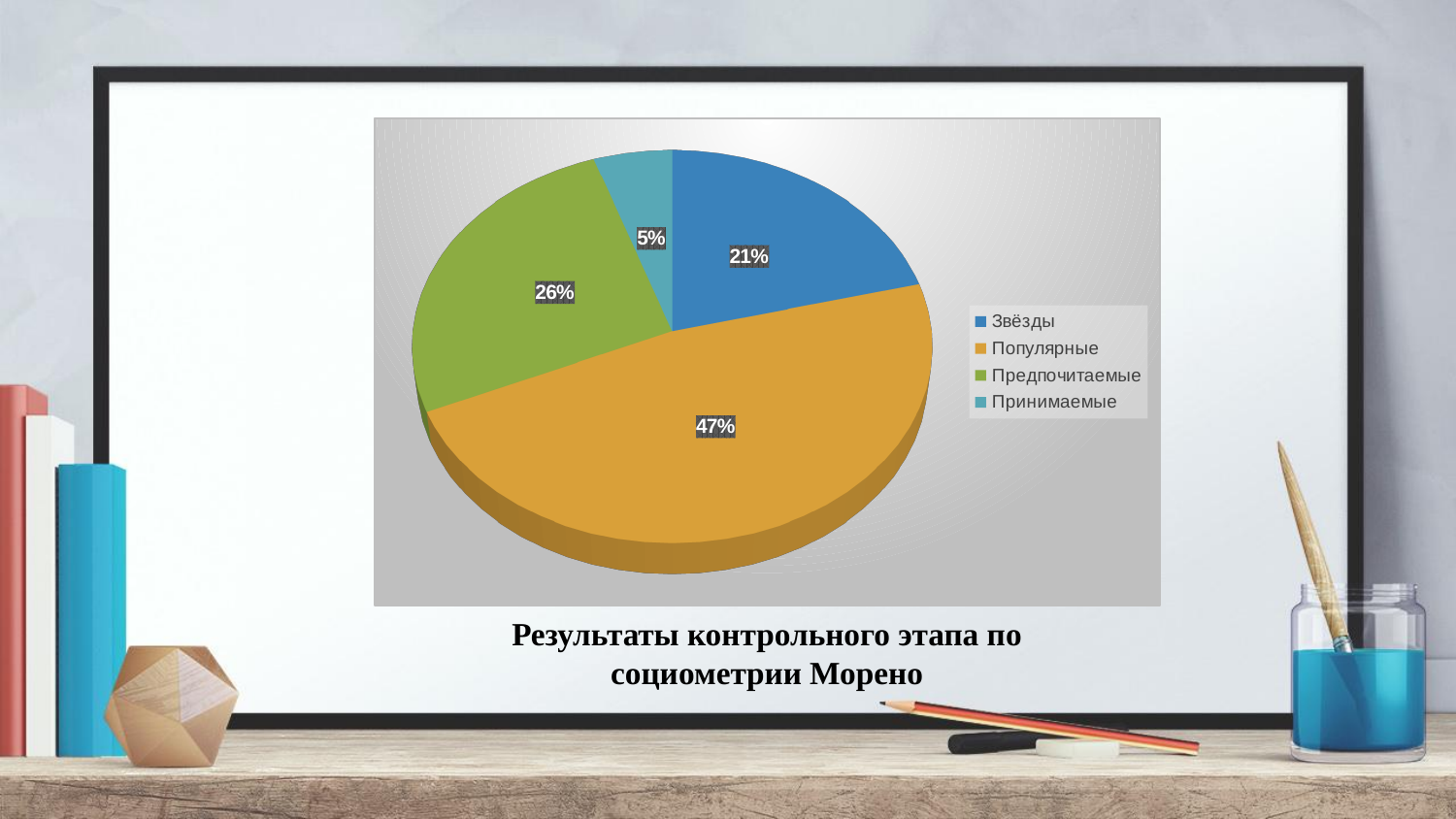
Which category has the smallest slice of the pie? Принимаемые What share of the pie does the Популярные slice take? 47% Which category has the largest slice of the pie? Популярные Which is larger, the Звёзды slice or the Предпочитаемые slice? Предпочитаемые What is the difference between the Популярные and Предпочитаемые shares? 21% What is the value shown for Предпочитаемые? 26% What colour is the Популярные slice in the pie chart? Orange What is the difference between the Звёзды and Принимаемые shares? 16% How many categories does the pie chart show? 4 What kind of chart is shown on the slide? Pie chart What is the value shown for Звёзды? 21% What is the value shown for Принимаемые? 5%